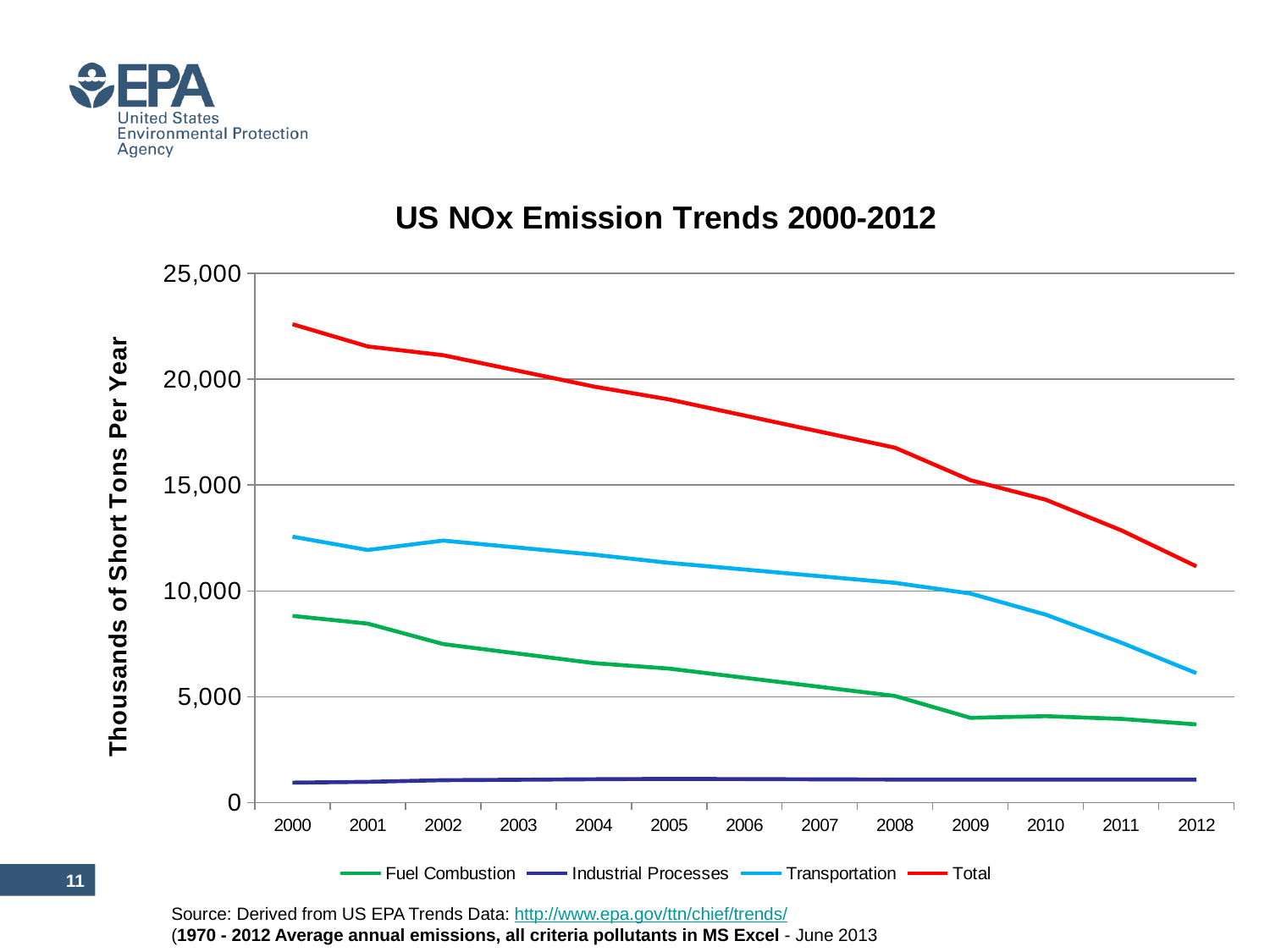
Is the value for Fuel Combustion in 2012 greater or less than 5,000? less How many years are plotted along the x axis? 13 In 2005, which is larger, Transportation or Fuel Combustion? Transportation Is the value for Total in 2000 greater or less than 20,000? greater Does the Total series rise or fall from 2000 to 2012? fall Which series has the lowest values across the chart? Industrial Processes Which series has the highest values across the chart? Total How many series does the legend list? 4 Is the value for Transportation in 2000 greater or less than 10,000? greater What is the title of the chart? US NOx Emission Trends 2000-2012 What kind of chart is shown on the slide? line chart